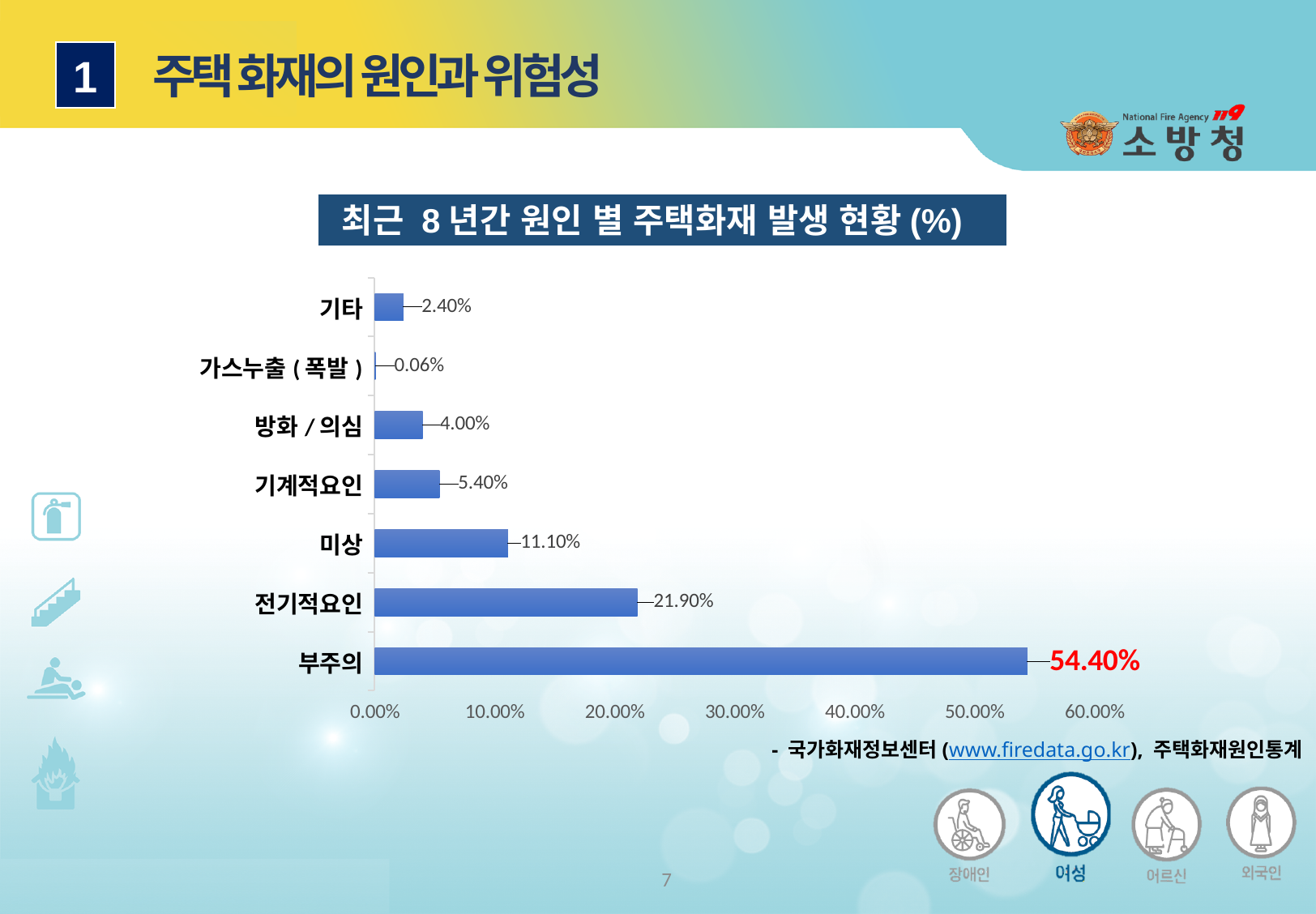
How many categories are shown in the chart? 7 What is the title of the chart? 최근 8 년간 원인 별 주택화재 발생 현황 (%) What is the value for 부주의? 54.40% What is the value for 전기적요인? 21.90% Which is larger, the value for 미상 or the value for 방화 / 의심? 미상 What is the difference between the values for 부주의 and 전기적요인? 32.50% What kind of chart is shown on the slide? bar chart What is the value for 가스누출 ( 폭발 )? 0.06% Which category has the highest value? 부주의 Is the value for 전기적요인 greater or less than 20.00%? greater What is the value for 기계적요인? 5.40% Which category has the lowest value? 가스누출 ( 폭발 )